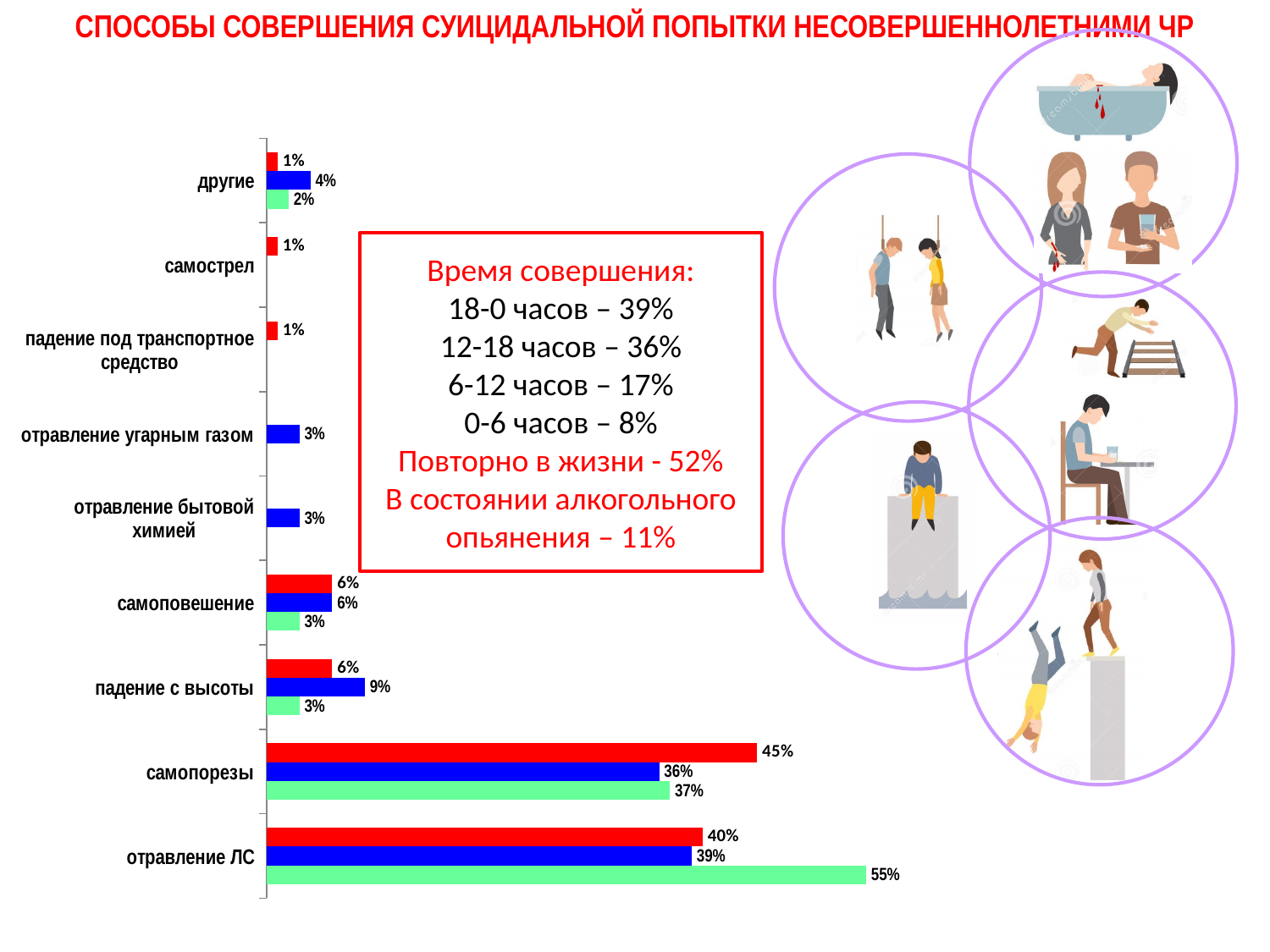
What is the value of the red bar for самопорезы? 45% What is the value of the green bar for отравление ЛС? 55% What type of chart is shown on the slide? bar chart What is the title of the slide? СПОСОБЫ СОВЕРШЕНИЯ СУИЦИДАЛЬНОЙ ПОПЫТКИ НЕСОВЕРШЕННОЛЕТНИМИ ЧР What is the value of the blue bar for падение с высоты? 9% What is the value of the red bar for самострел? 1% Which is larger: the green bar for самопорезы or the green bar for самоповешение? самопорезы Which category has the highest red bar? самопорезы Which category has the highest green bar? отравление ЛС How many categories are listed on the vertical axis of the bar chart? 9 What is the difference between the red bar and the blue bar for самопорезы? 9% What is the value of the blue bar for другие? 4%